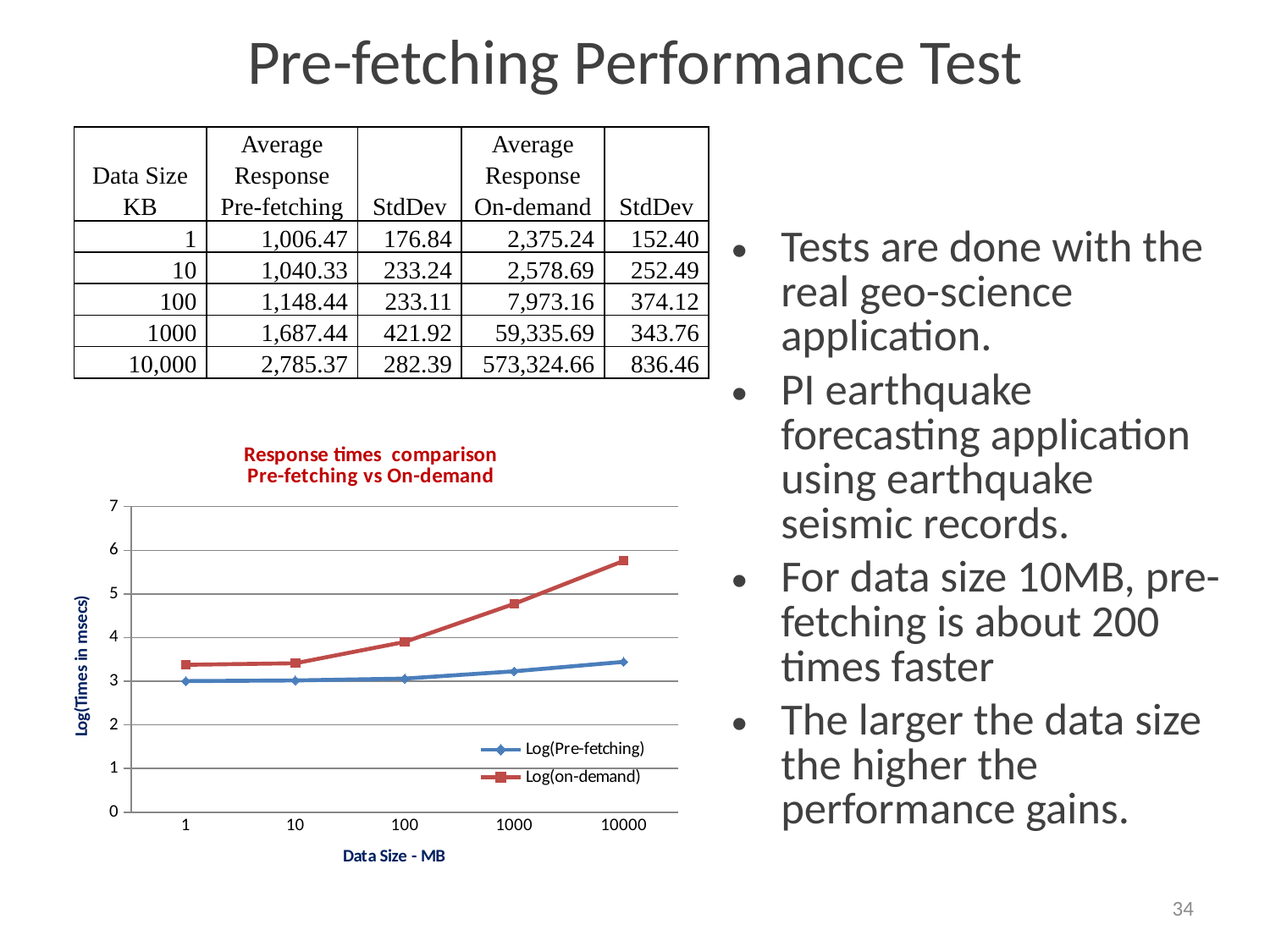
Is the value of Log(Pre-fetching) at data size 1 greater or less than 4? less At which data size does the Log(Pre-fetching) series reach its highest value? 10000 How many series does the chart legend list? 2 Is the value of Log(on-demand) at data size 10000 greater or less than 5? greater What colour is the Log(on-demand) line in the chart? red Does the Log(on-demand) series rise or fall as data size increases along the x axis? rises At which data size does the Log(on-demand) series reach its highest value? 10000 What type of chart is shown on the slide? line chart Is the value of Log(on-demand) at data size 1000 greater or less than 4? greater What is the label of the chart's y axis? Log(Times in msecs) How many data sizes are plotted along the x axis of the chart? 5 Which series has the higher value at data size 10000? Log(on-demand)